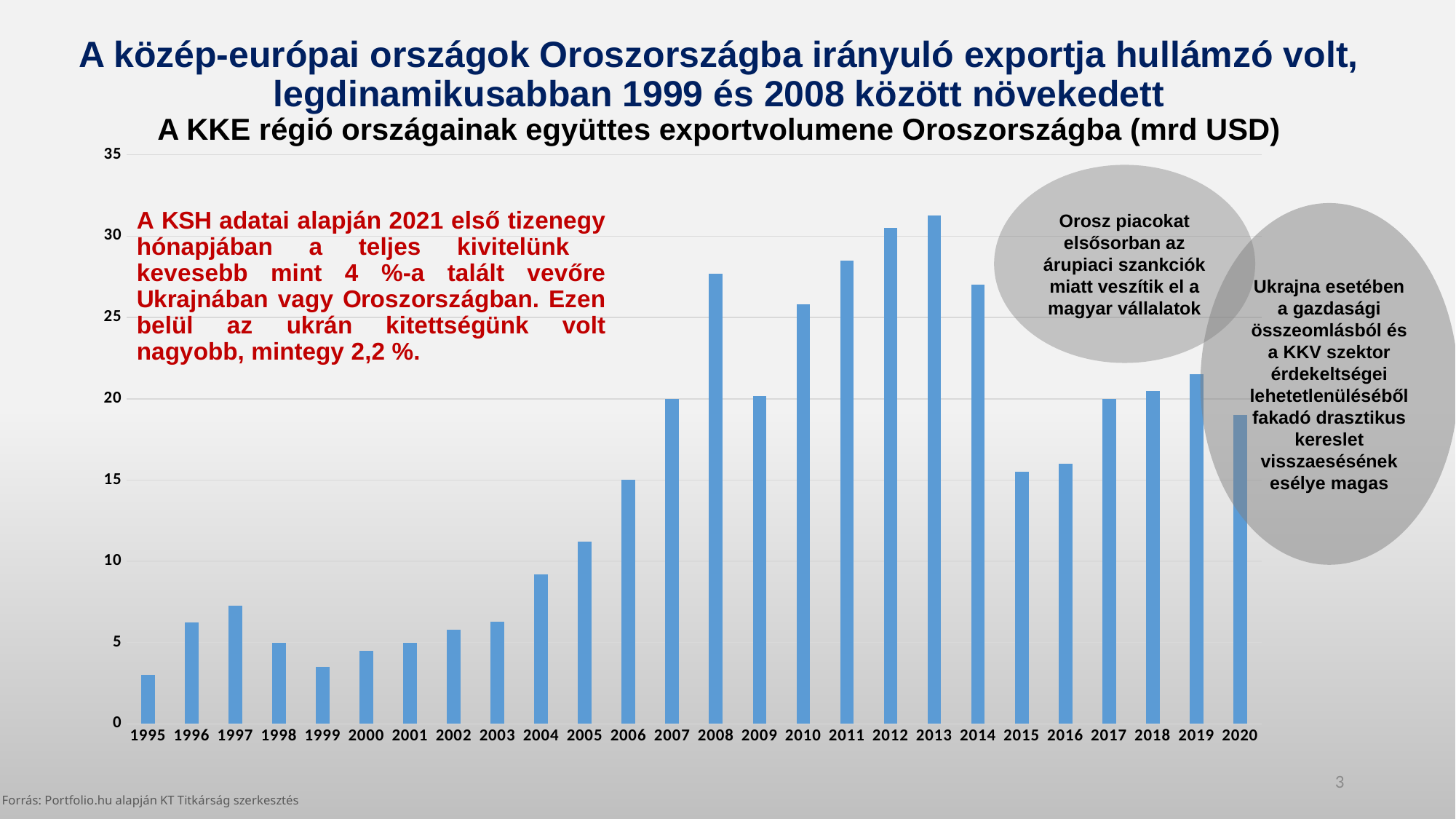
Is the value for 2006 greater or less than 10? greater Do the values rise or fall from 1999 to 2008? rise How many years (bars) are plotted on the chart? 26 Which is larger, the value for 1997 or the value for 1998? 1997 Which year has the highest export volume on the chart? 2013 Which is larger, the value for 2008 or the value for 2009? 2008 Is the value for 1995 greater or less than 5? less What kind of chart is shown on the slide? bar chart Is the value for 2013 greater or less than 30? greater In what unit is the export volume expressed according to the chart title? mrd USD